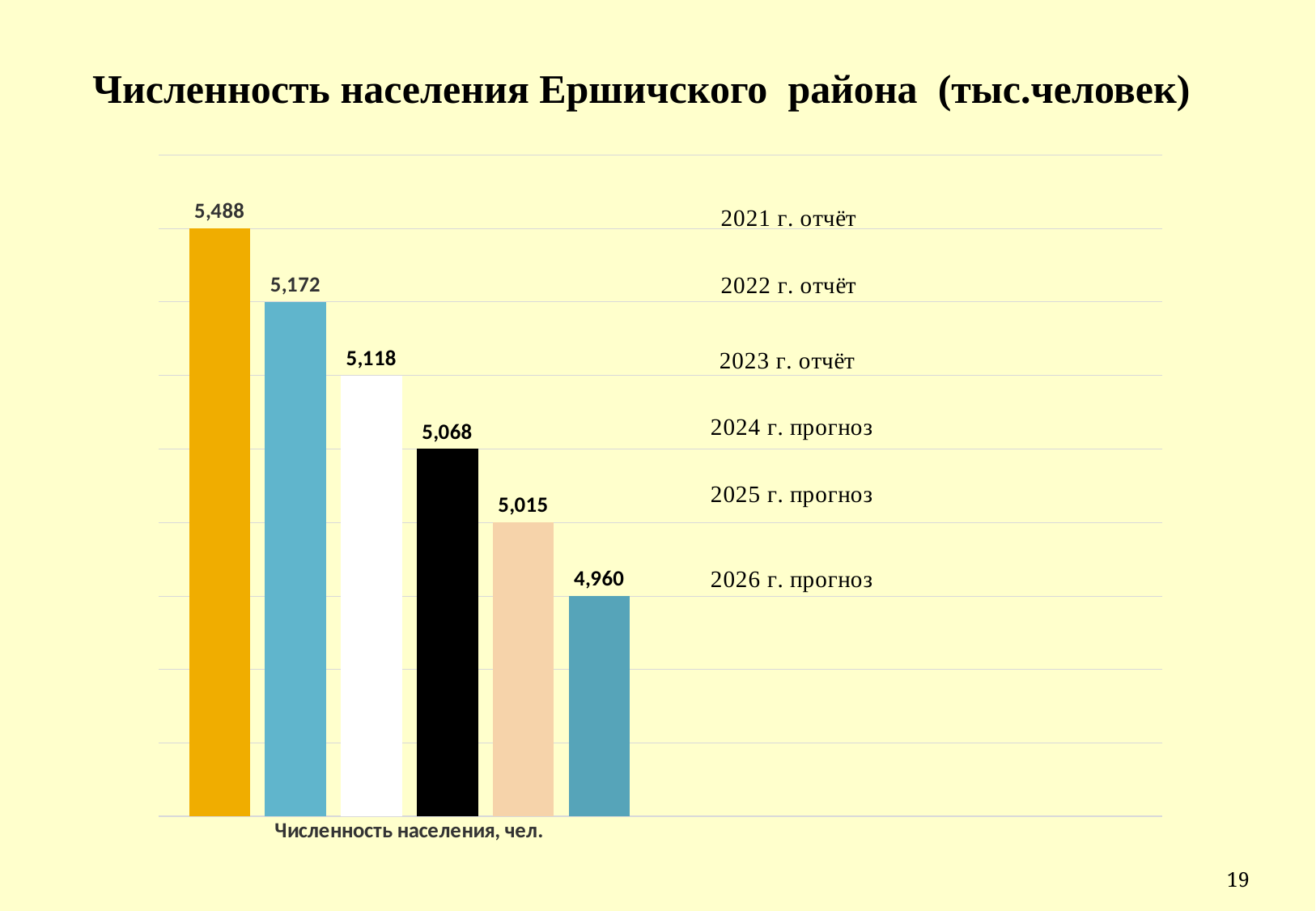
What is the population value shown for 2023 г. отчёт? 5,118 Which is larger, the value for 2024 г. прогноз or the value for 2025 г. прогноз? 2024 г. прогноз Do the population values rise or fall from 2021 to 2026? fall What is the title of the chart? Численность населения Ершичского района (тыс.человек) Which year has the highest population value in the chart? 2021 г. отчёт What is the difference between the values for 2021 г. отчёт and 2022 г. отчёт? 316 How many bars are plotted in the chart? 6 Which year has the lowest population value in the chart? 2026 г. прогноз What is the population value shown for 2026 г. прогноз? 4,960 What type of chart is shown on the slide? bar chart What is the difference between the values for 2021 г. отчёт and 2026 г. прогноз? 528 What is the population value shown for 2021 г. отчёт? 5,488